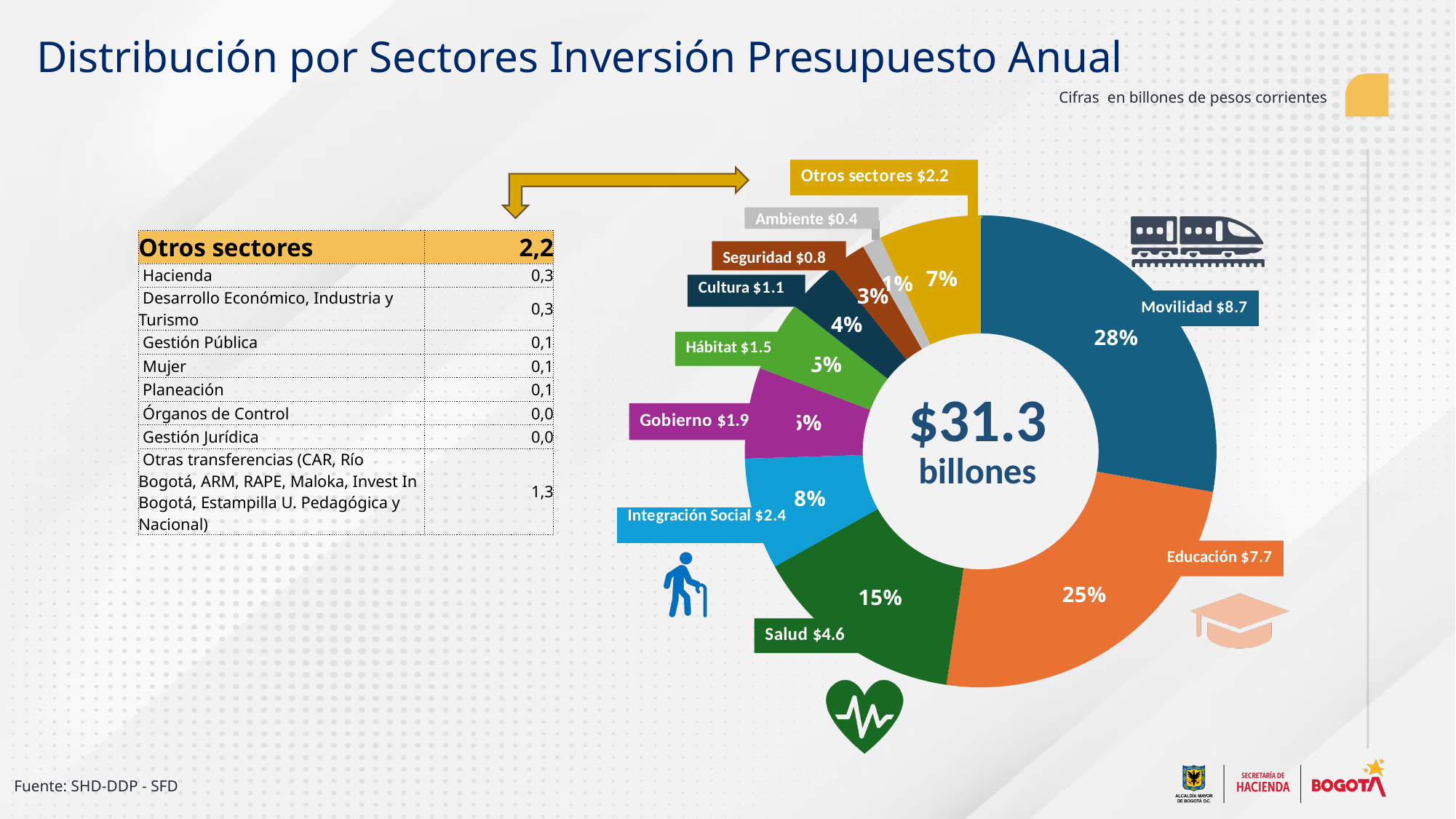
What kind of chart is shown on the slide? Pie chart (donut) What is the difference between the values for Movilidad and Educación? $1.0 Which sector has the smallest share of the chart? Ambiente Which sector has the largest share of the chart? Movilidad What is the value shown for Educación? $7.7 What percentage share does Otros sectores have in the chart? 7% What is the value shown for Movilidad? $8.7 What percentage share does Salud have in the chart? 15% What total value is shown in the centre of the chart? $31.3 billones Which is larger, the value for Integración Social or the value for Gobierno? Integración Social What is the value shown for Seguridad? $0.8 How many sectors are shown in the chart? 10